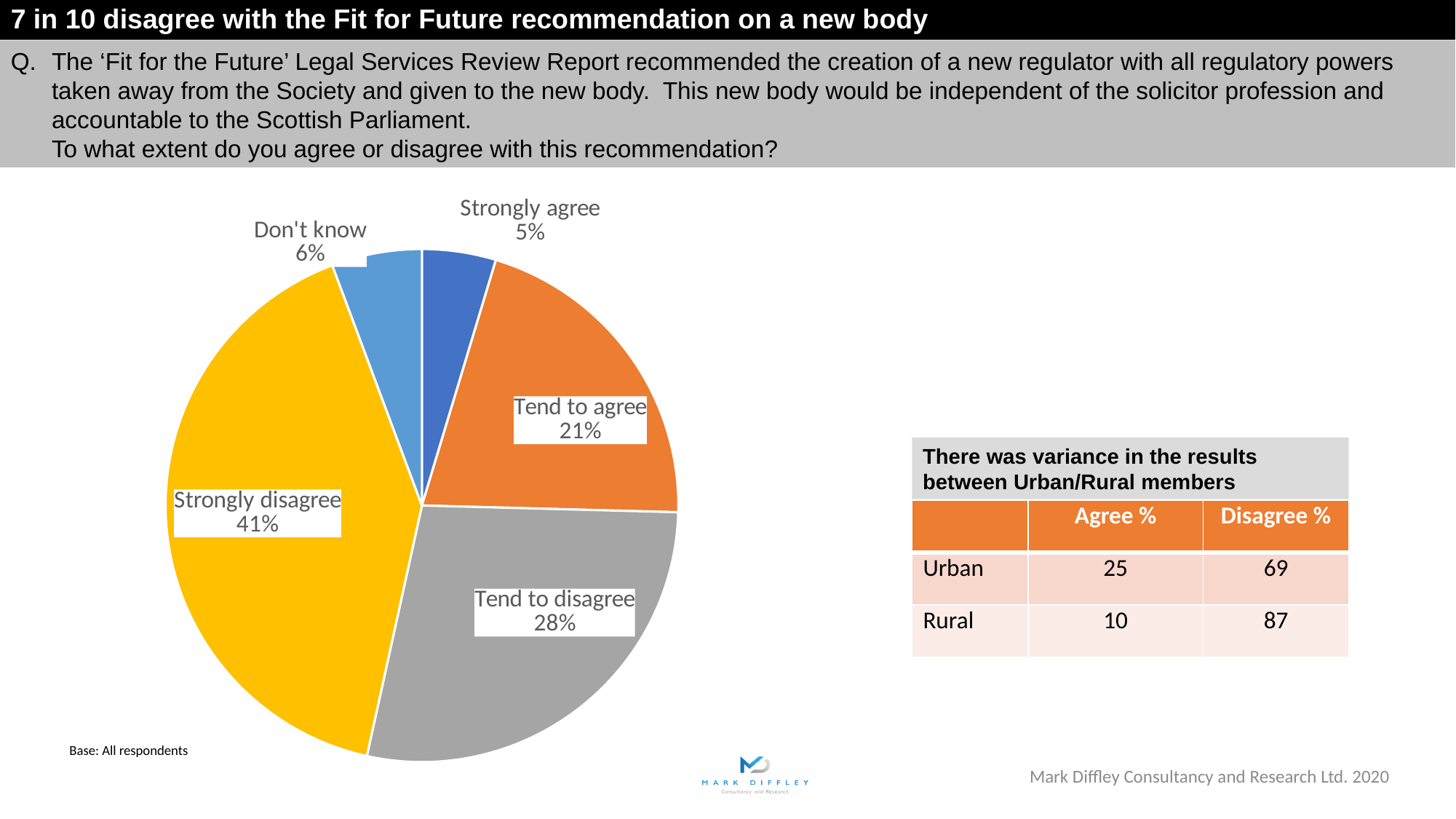
Which is larger, the share for 'Tend to agree' or the share for 'Tend to disagree'? Tend to disagree What percentage of respondents strongly disagree with the recommendation? 41% What type of chart is shown on the slide? Pie chart What percentage of respondents answered 'Don't know'? 6% What colour is the 'Tend to disagree' slice of the pie chart? Grey How many slices does the pie chart have? 5 What percentage of respondents tend to agree with the recommendation? 21% What is the difference in percentage points between 'Strongly disagree' and 'Tend to disagree'? 13 Which response category has the smallest share of the pie? Strongly agree Which response category has the largest share of the pie? Strongly disagree What is the combined percentage of 'Strongly agree' and 'Tend to agree'? 26% What colour is the 'Strongly disagree' slice of the pie chart? Yellow